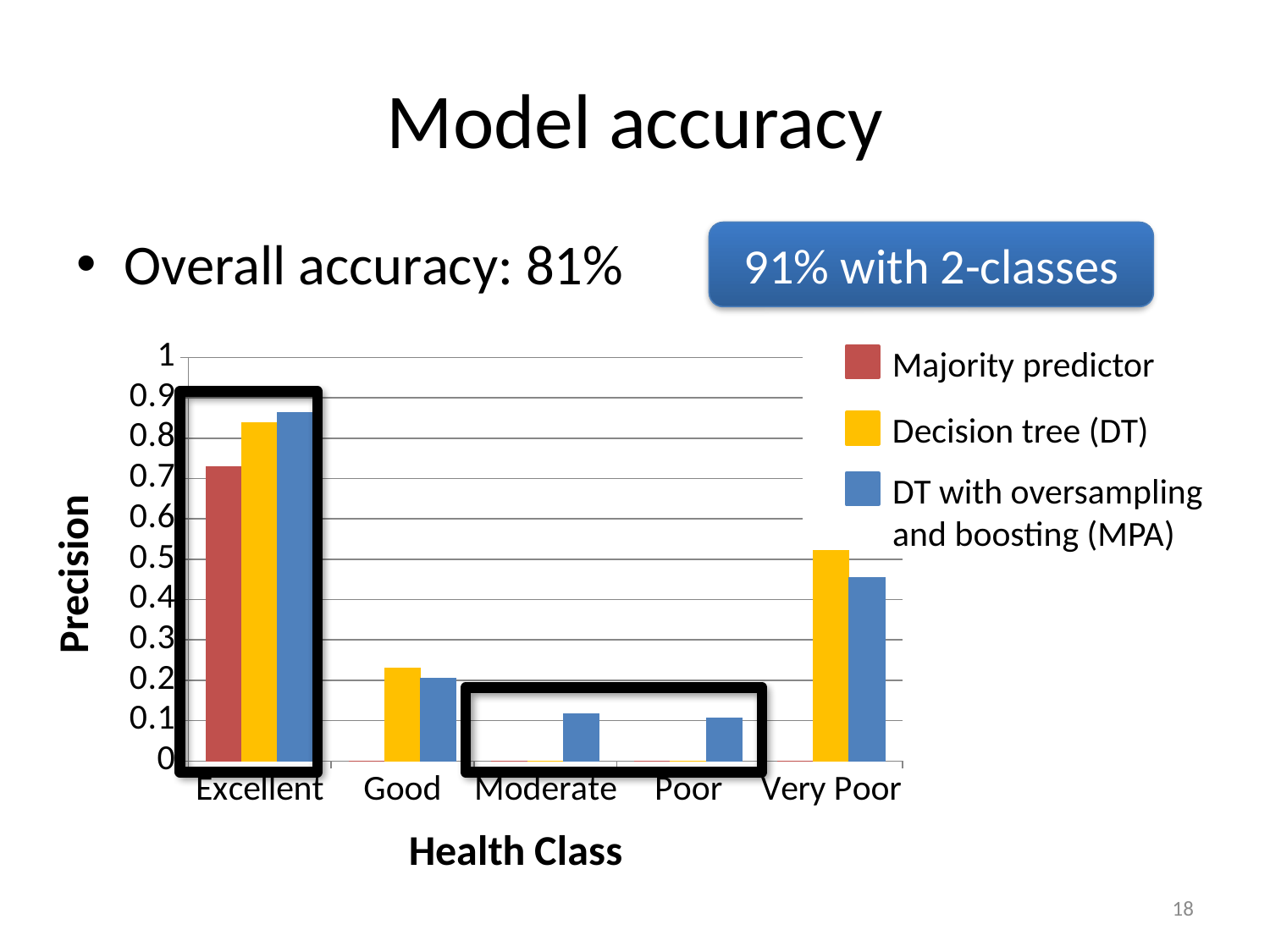
What kind of chart is shown on the slide? bar chart Is the precision of DT with oversampling and boosting (MPA) for the Good class greater or less than 0.3? less How many health classes are shown on the x axis of the chart? 5 Is the precision of the Majority predictor for the Excellent class greater or less than 0.5? greater Is the precision of DT with oversampling and boosting (MPA) for the Moderate class greater or less than 0.2? less What is the label of the y axis of the chart? Precision For the Excellent class, which has the higher precision: the Majority predictor or the Decision tree (DT)? Decision tree (DT) For the Very Poor class, which has the higher precision: the Decision tree (DT) or DT with oversampling and boosting (MPA)? Decision tree (DT) Which series in the chart is shown in red? Majority predictor How many series does the chart legend list? 3 For which health class does DT with oversampling and boosting (MPA) have the highest precision? Excellent